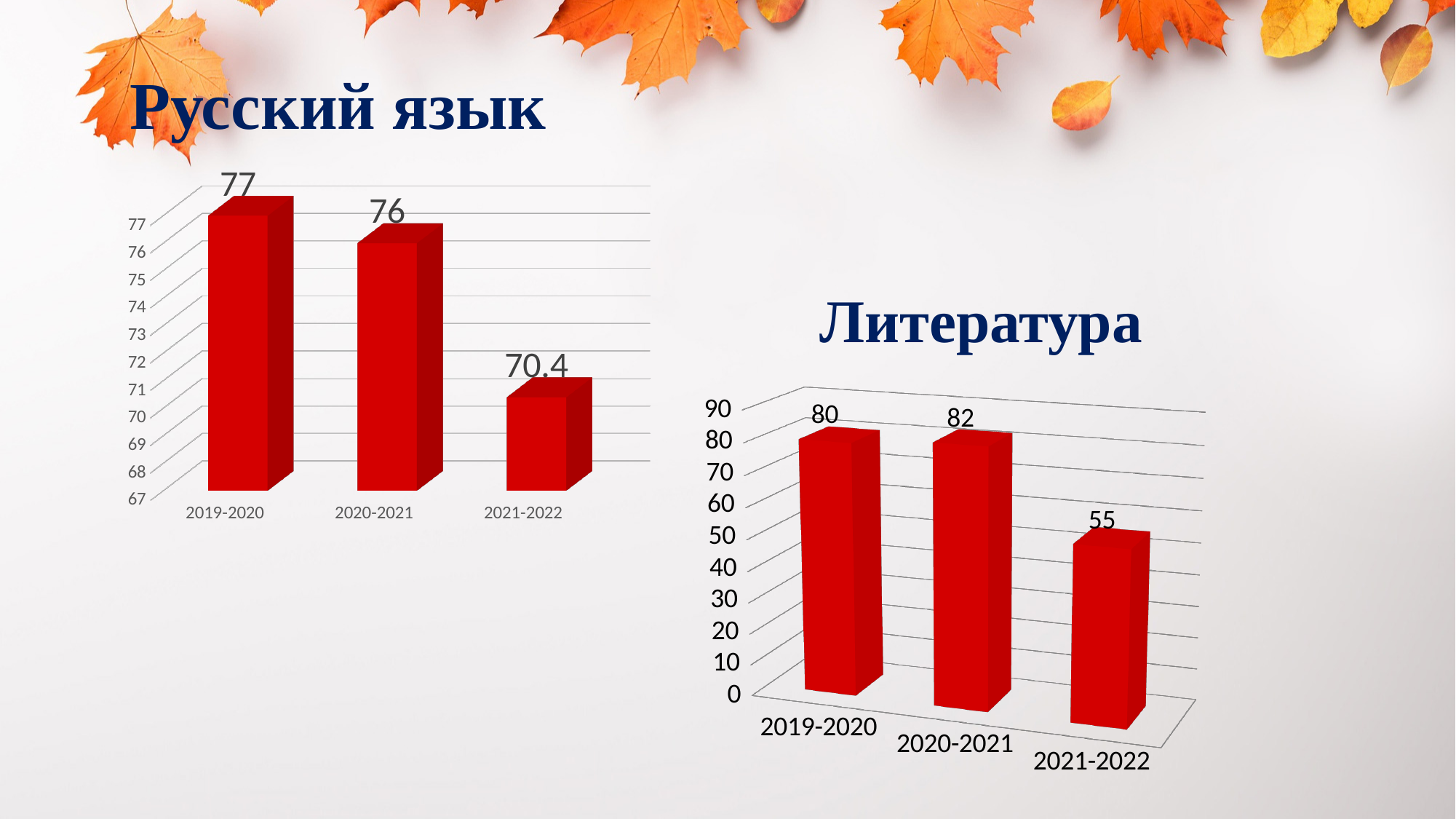
In the Русский язык chart, do the values rise or fall from 2019-2020 to 2021-2022? fall In the Русский язык chart, which year has the lowest value? 2021-2022 In the Литература chart, what is the value for 2020-2021? 82 In the Литература chart, which is larger: the value for 2019-2020 or the value for 2021-2022? 2019-2020 In the Русский язык chart, what is the value for 2019-2020? 77 In the Литература chart, what is the value for 2021-2022? 55 In the Русский язык chart, what is the value for 2021-2022? 70.4 How many categories are shown in the Литература chart? 3 In the Литература chart, which year has the highest value? 2020-2021 What kind of chart is the Русский язык chart? bar chart In the Литература chart, what is the difference between the values for 2020-2021 and 2021-2022? 27 In the Русский язык chart, what is the difference between the values for 2019-2020 and 2021-2022? 6.6